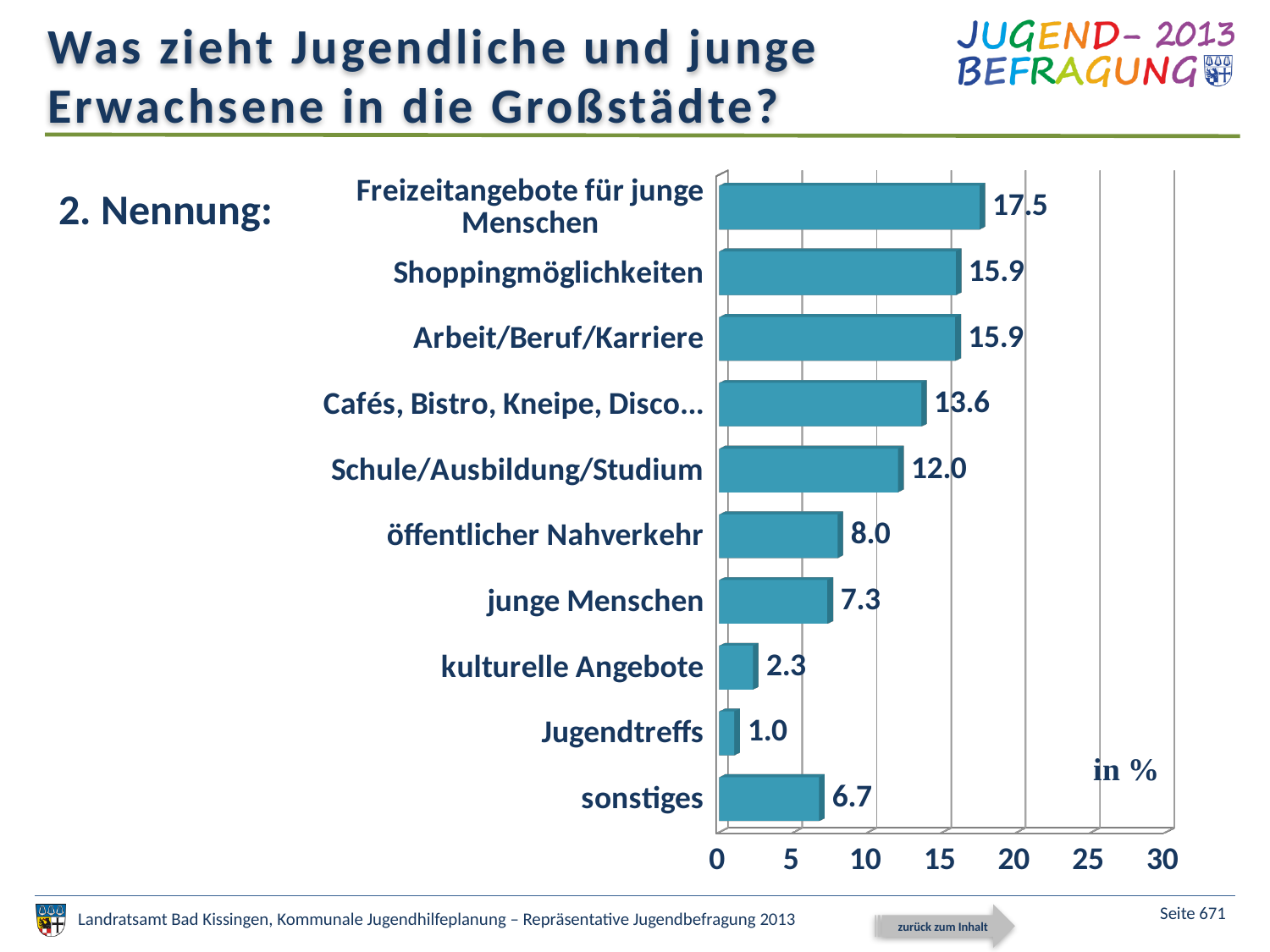
Is the value for Arbeit/Beruf/Karriere greater or less than 10? greater What kind of chart is shown on the slide? bar chart What is the value for Shoppingmöglichkeiten? 15.9 What unit is indicated for the values in the chart? in % What is the value for sonstiges? 6.7 How many categories are shown in the chart? 10 What is the difference between the values for kulturelle Angebote and Jugendtreffs? 1.3 Which category has the highest value? Freizeitangebote für junge Menschen What is the value for öffentlicher Nahverkehr? 8.0 Which is larger, the value for Cafés, Bistro, Kneipe, Disco… or the value for junge Menschen? Cafés, Bistro, Kneipe, Disco… What is the difference between the values for Freizeitangebote für junge Menschen and Schule/Ausbildung/Studium? 5.5 Which category has the lowest value? Jugendtreffs